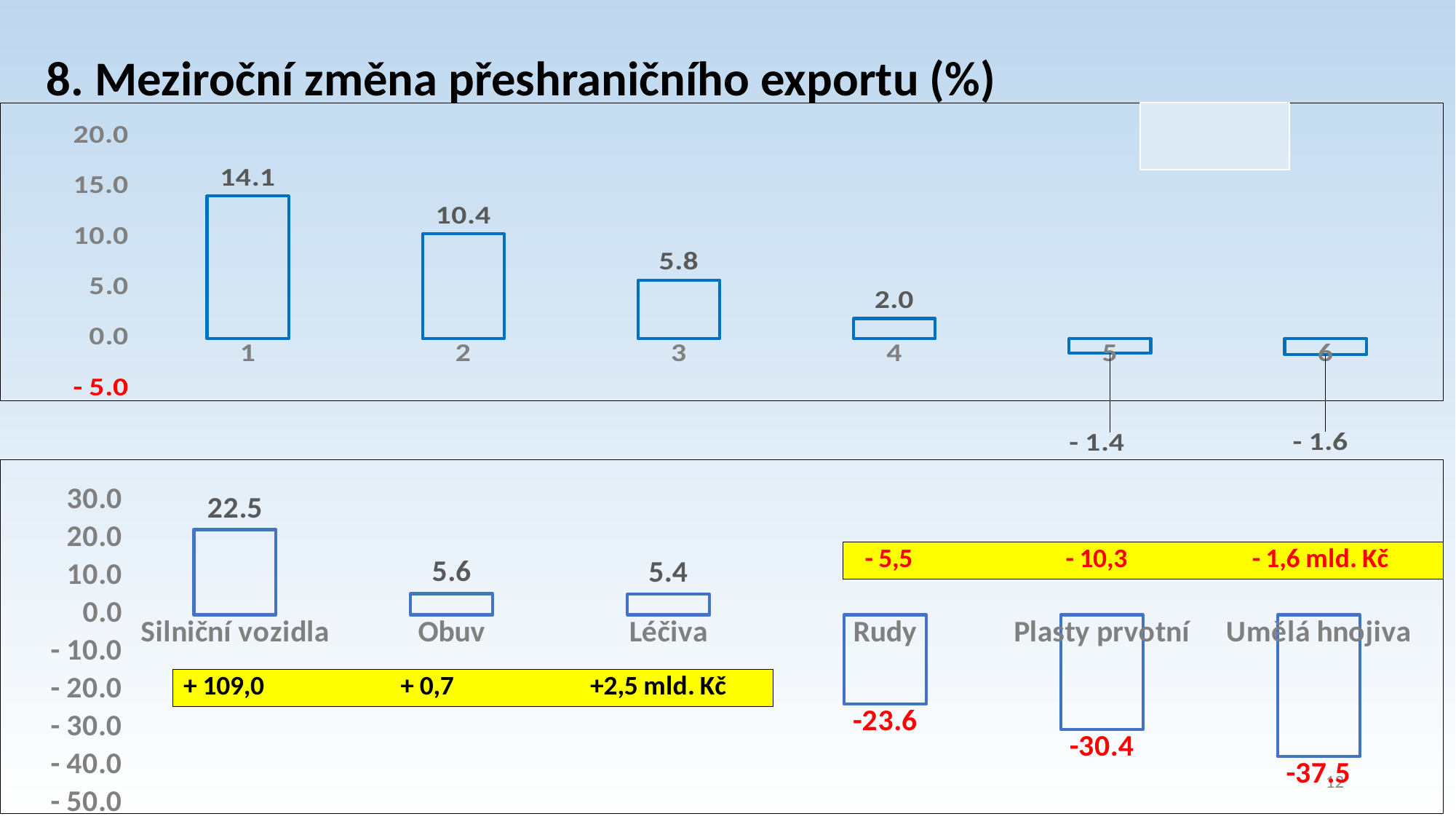
What kind of chart is the bottom chart? bar chart In the bottom chart, which is larger, the value for Obuv or the value for Léčiva? Obuv In the bottom chart, what is the value for Silniční vozidla? 22.5 In the bottom chart, what is the value for Plasty prvotní? -30.4 In the bottom chart, what is the difference between the values for Silniční vozidla and Obuv? 16.9 In the top chart, which category has the highest value? 1 In the top chart, what is the value for category 1? 14.1 In the top chart, what is the difference between the values for category 1 and category 2? 3.7 In the top chart, what is the value for category 6? - 1.6 In the top chart, what is the value for category 4? 2.0 In the bottom chart, which category has the lowest value? Umělá hnojiva In the top chart, how many bars are plotted? 6